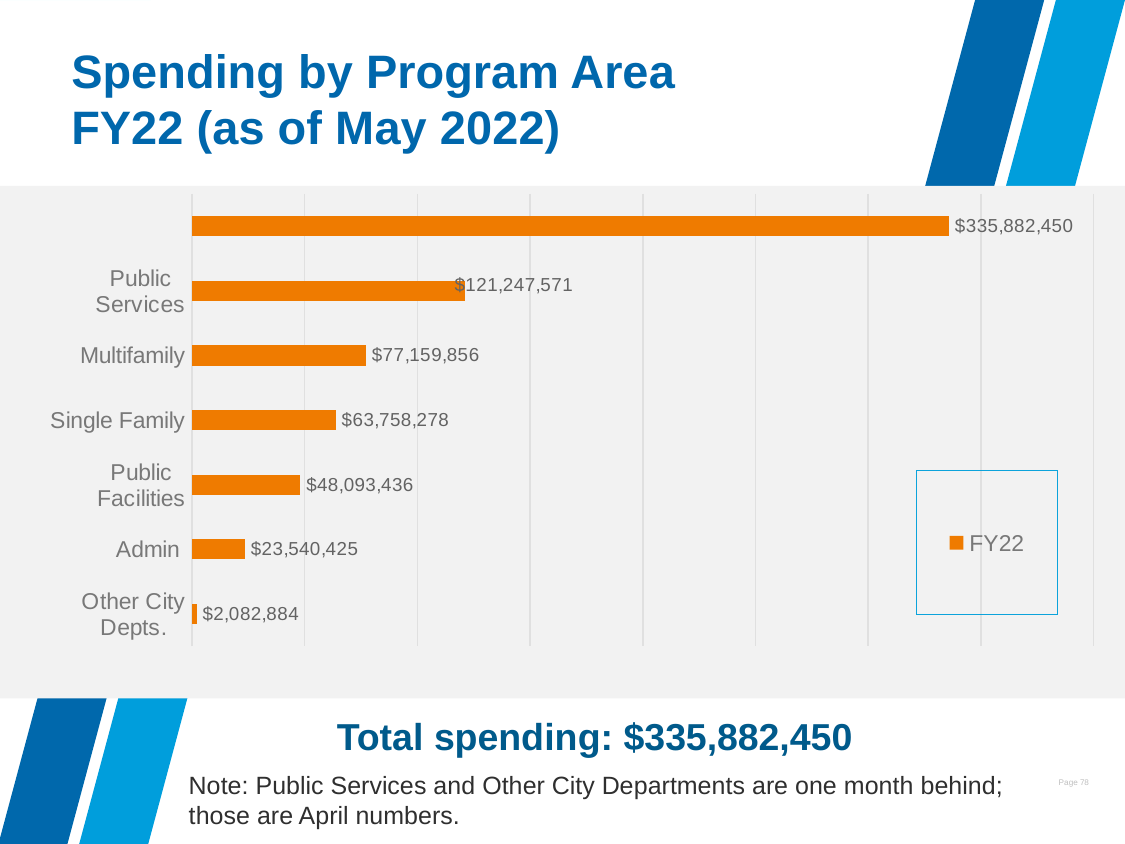
What is the value for Admin? $23,540,425 What is the value for Single Family? $63,758,278 Which is larger, Public Facilities or Admin? Public Facilities What is the value for Public Services? $121,247,571 What is the value for Other City Depts.? $2,082,884 What kind of chart is shown? Bar chart Which labeled program area has the highest spending? Public Services Which labeled program area has the lowest spending? Other City Depts. What is the value for Public Facilities? $48,093,436 What is the difference between Multifamily and Single Family spending? $13,401,578 What is the value for Multifamily? $77,159,856 What series does the legend list? FY22